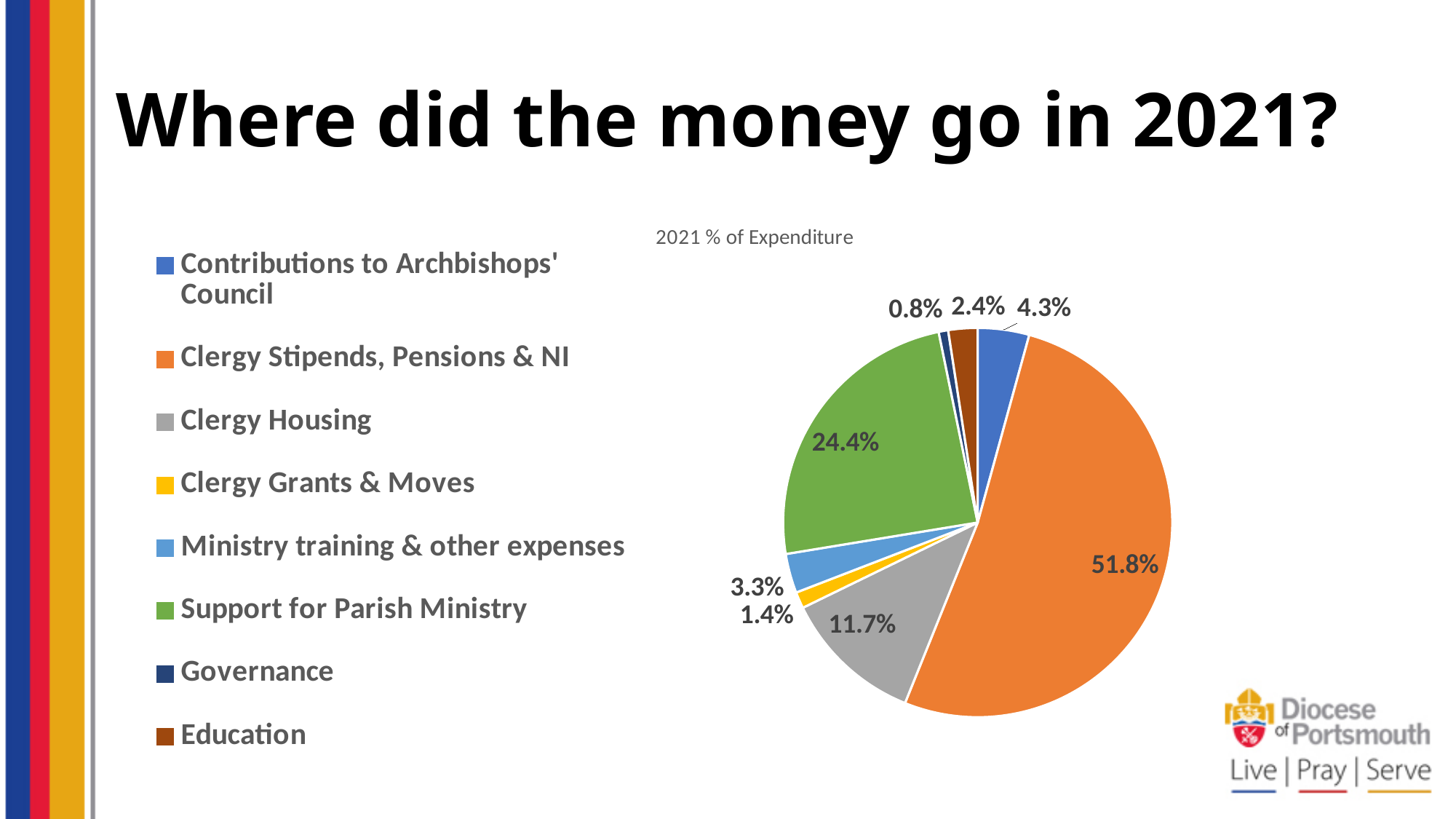
What percentage of expenditure went to Governance? 0.8% What is the difference in percentage points between Clergy Stipends, Pensions & NI and Support for Parish Ministry? 27.4 How many categories does the legend list? 8 What type of chart is shown on the slide? pie chart What percentage of expenditure went to Education? 2.4% What percentage of expenditure went to Support for Parish Ministry? 24.4% Which category accounts for the largest share of expenditure? Clergy Stipends, Pensions & NI Which category accounts for the smallest share of expenditure? Governance What percentage of expenditure went to Clergy Stipends, Pensions & NI? 51.8% What is the title of the chart? 2021 % of Expenditure What percentage of expenditure went to Clergy Housing? 11.7% Which is larger: the share for Ministry training & other expenses or the share for Clergy Grants & Moves? Ministry training & other expenses